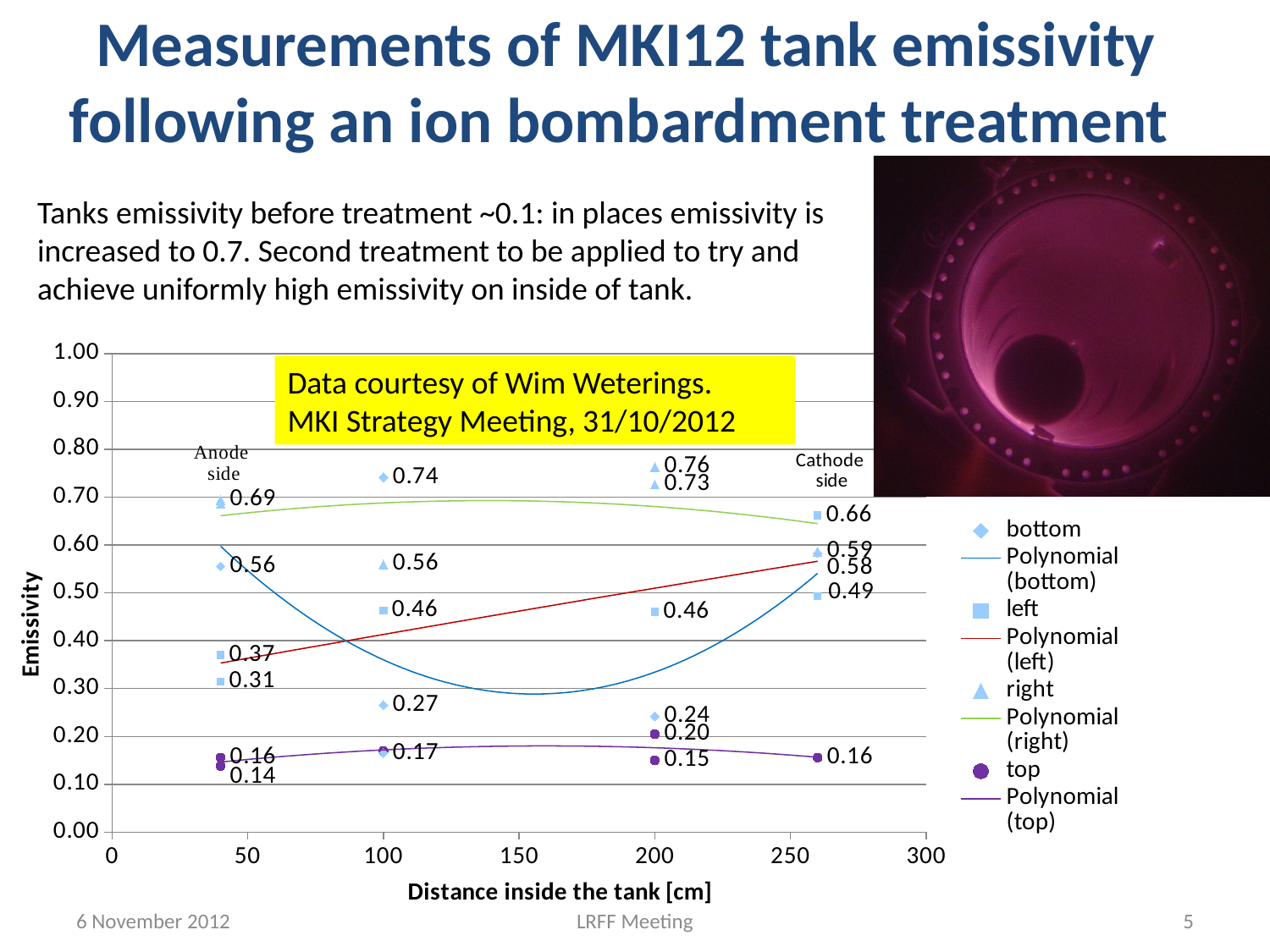
What is the emissivity value labelled for the bottom series at 100 cm (the upper point)? 0.74 What is the emissivity value labelled for the left series at 200 cm? 0.46 How many entries does the chart legend list? 8 What is the emissivity value labelled for the top series at 100 cm? 0.17 What is the emissivity value labelled for the top series at 260 cm? 0.16 What is the lowest emissivity value labelled on the chart? 0.14 What kind of chart is shown on the slide? scatter chart What is the highest emissivity value labelled on the chart? 0.76 At 100 cm, which series has the larger labelled value: bottom (0.74) or right (0.56)? bottom What is the difference between the two bottom-series values at 100 cm (0.74 and 0.27)? 0.47 What is the title of the y axis? Emissivity What is the title of the x axis? Distance inside the tank [cm]